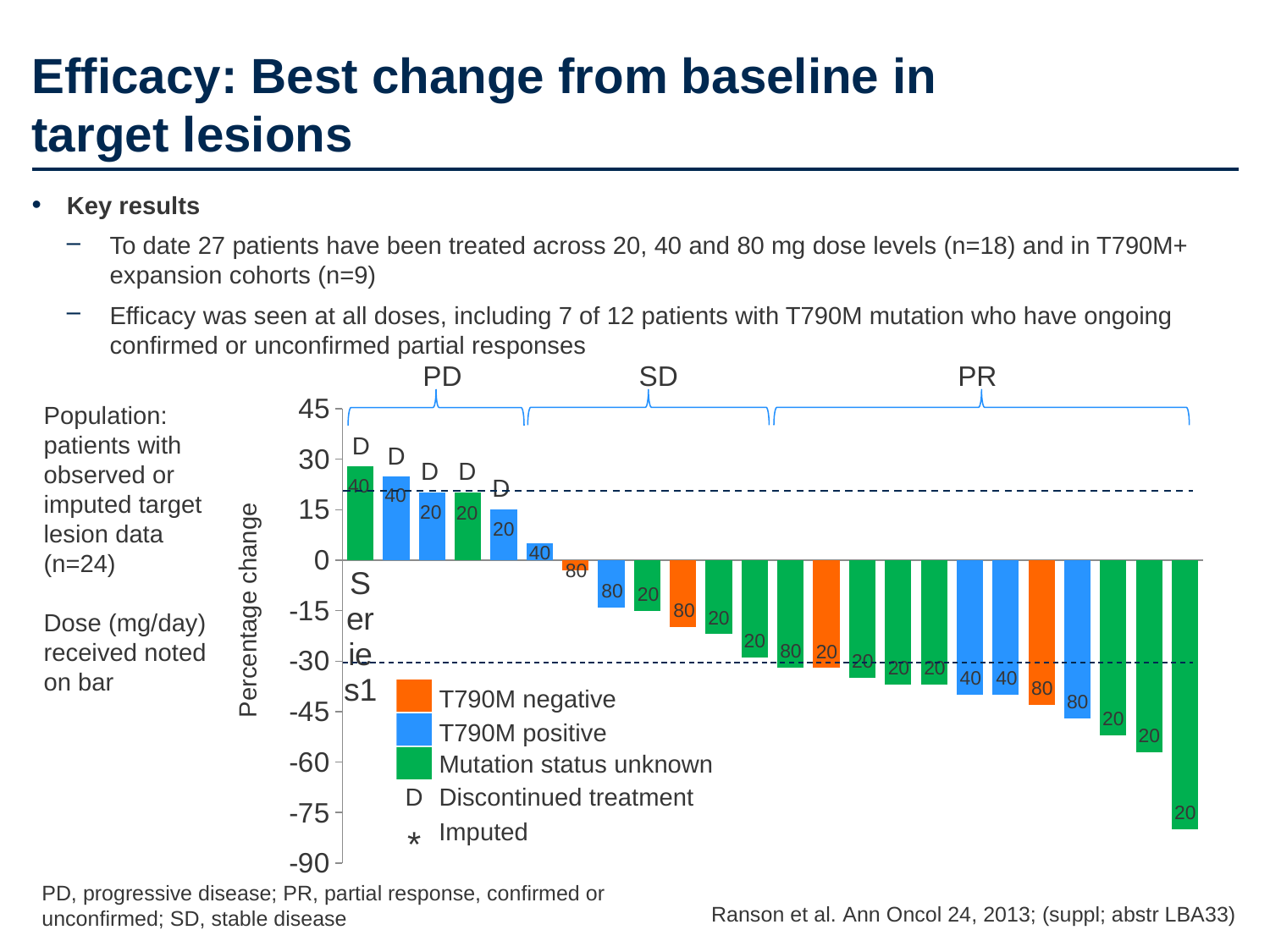
Do the bar values rise or fall moving from left to right along the chart? Fall Which bar shows the largest percentage change from baseline: the leftmost bar or the rightmost bar? The rightmost bar What is the label of the vertical axis of the chart? Percentage change How many mutation status categories does the chart legend list? 3 How many orange (T790M negative) bars are in the chart? 4 Which colour represents T790M negative patients in the chart? Orange Is the value of the orange bar labelled 80 in the PR group greater or less than -30? less How many bars are marked with a D for discontinued treatment? 5 What kind of chart is shown on the slide? Bar chart How many bars (patients) are plotted in the chart? 24 Is the value of the rightmost bar (dose 20) greater or less than -60? less Is the value of the leftmost bar (dose 40, marked D) greater or less than 15? greater